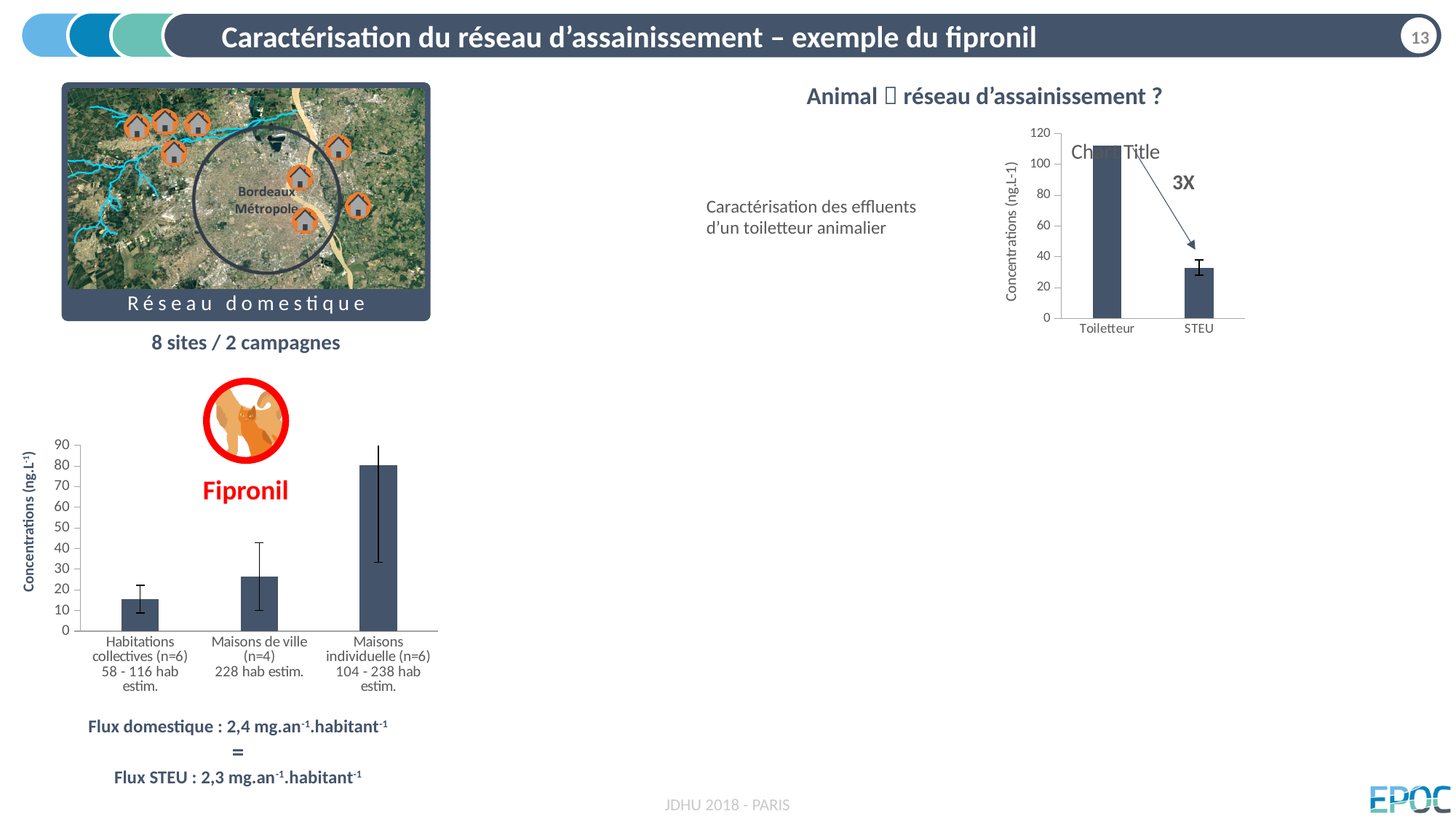
On the right-hand chart titled 'Chart Title', which category has the higher concentration? Toiletteur On the bottom-left chart, is the value for Maisons de ville greater or less than 20? greater How many categories are shown on the bottom-left chart? 3 On the bottom-left chart, which category has the highest concentration? Maisons individuelle (n=6) On the bottom-left chart, which category has the lowest concentration? Habitations collectives (n=6) On the right-hand chart titled 'Chart Title', is the value for STEU greater or less than 40? less On the bottom-left chart, do the values rise or fall from left to right along the x axis? rise On the bottom-left chart, is the value for Habitations collectives greater or less than 20? less On the bottom-left chart, which is larger: the value for Maisons de ville or the value for Habitations collectives? Maisons de ville What kind of chart is the bottom-left chart? bar chart